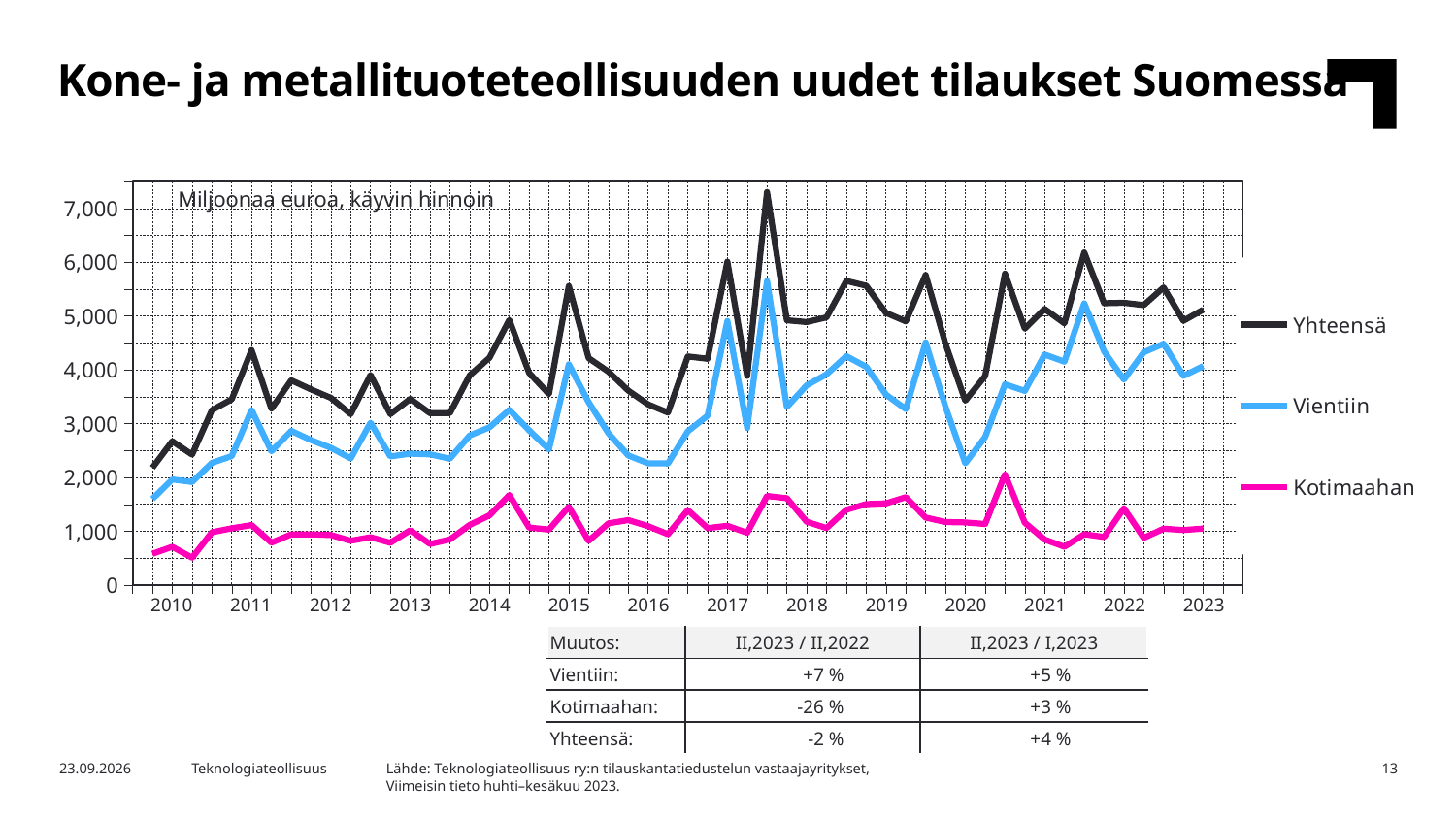
Which series is larger in 2023, Vientiin or Kotimaahan? Vientiin What unit is stated in the text at the top of the chart area? Miljoonaa euroa, käyvin hinnoin How many series does the chart legend list? 3 What are the three series named in the chart legend? Yhteensä, Vientiin, Kotimaahan Which series has the lowest values throughout the chart? Kotimaahan Is the peak value of the Yhteensä series in 2017 greater or less than 7,000? greater According to the table below the chart, what is the change for Vientiin in II,2023 / II,2022? +7 % Is the value of the Kotimaahan series at the start of 2010 greater or less than 1,000? less Which series has the highest values throughout the chart? Yhteensä Is the value of the Vientiin series at the start of 2010 greater or less than 2,000? less How many year labels are shown on the x axis? 14 What type of chart is shown on the slide? line chart